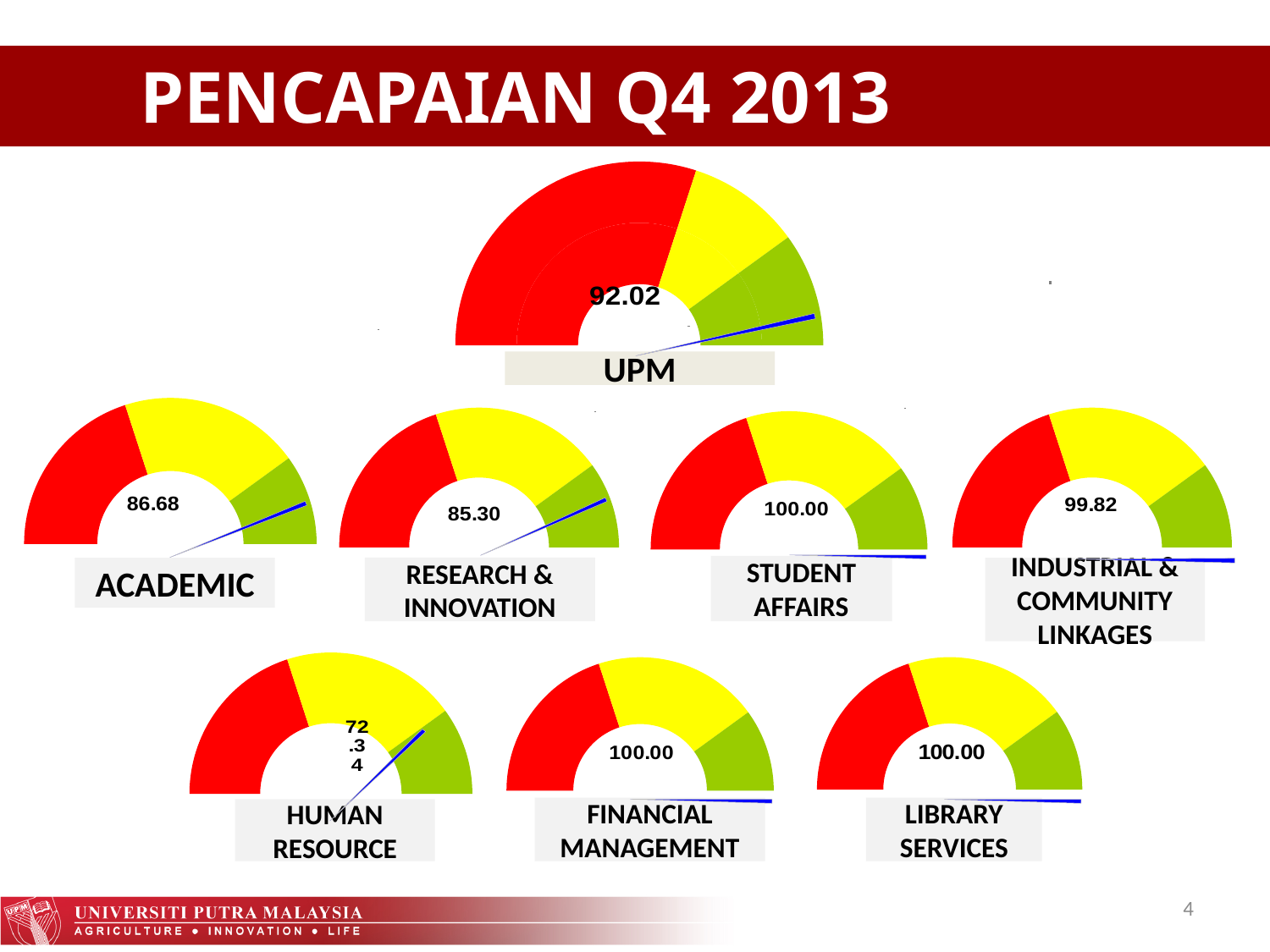
Which gauge on the slide shows the lowest value? HUMAN RESOURCE What value is shown on the INDUSTRIAL & COMMUNITY LINKAGES gauge? 99.82 What value is shown on the UPM gauge? 92.02 How many gauges on the slide show a value of 100.00? 3 What value is shown on the STUDENT AFFAIRS gauge? 100.00 Which shows a higher value, the ACADEMIC gauge or the RESEARCH & INNOVATION gauge? ACADEMIC How many gauge charts are shown on the slide in total? 8 What value is shown on the ACADEMIC gauge? 86.68 What is the difference between the UPM gauge value and the HUMAN RESOURCE gauge value? 19.68 What value is shown on the RESEARCH & INNOVATION gauge? 85.30 What kind of chart is used to display the values on this slide? Gauge chart What value is shown on the HUMAN RESOURCE gauge? 72.34